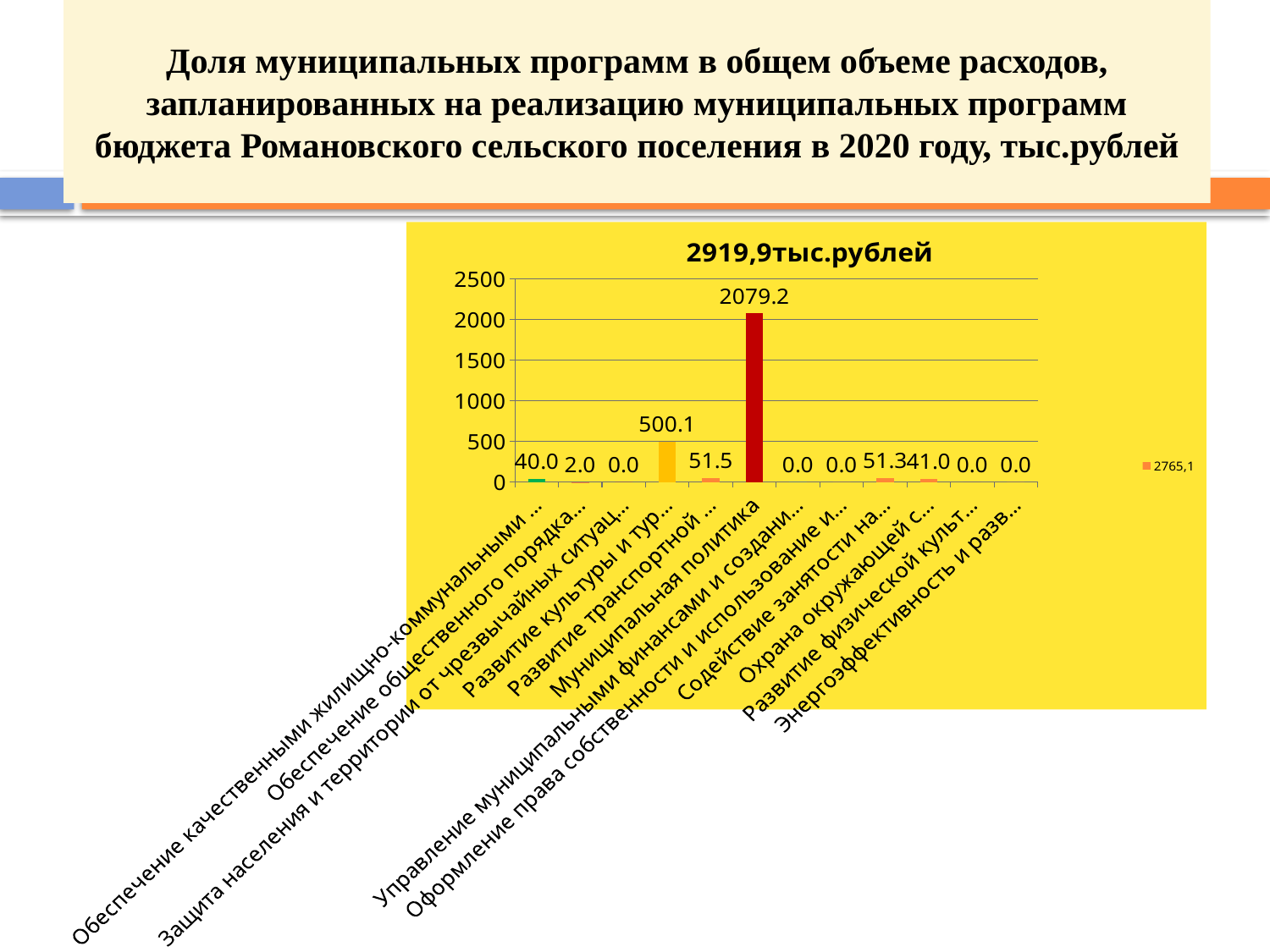
What is the value for Обеспечение общественного порядка...? 2.0 What is the difference between the values for Обеспечение качественными жилищно-коммунальными ... and Охрана окружающей с...? 1.0 What is the difference between the values for Муниципальная политика and Развитие культуры и тур...? 1579.1 What type of chart is shown on the slide? bar chart What is the value for Развитие культуры и тур...? 500.1 How many categories are shown on the x axis? 12 Which category has the highest value? Муниципальная политика What is the value for Муниципальная политика? 2079.2 What is the value for Развитие транспортной ...? 51.5 How many series does the legend list? 1 What is the title of the chart? 2919,9тыс.рублей Which is larger, the value for Содействие занятости на... or the value for Охрана окружающей с...? Содействие занятости на...